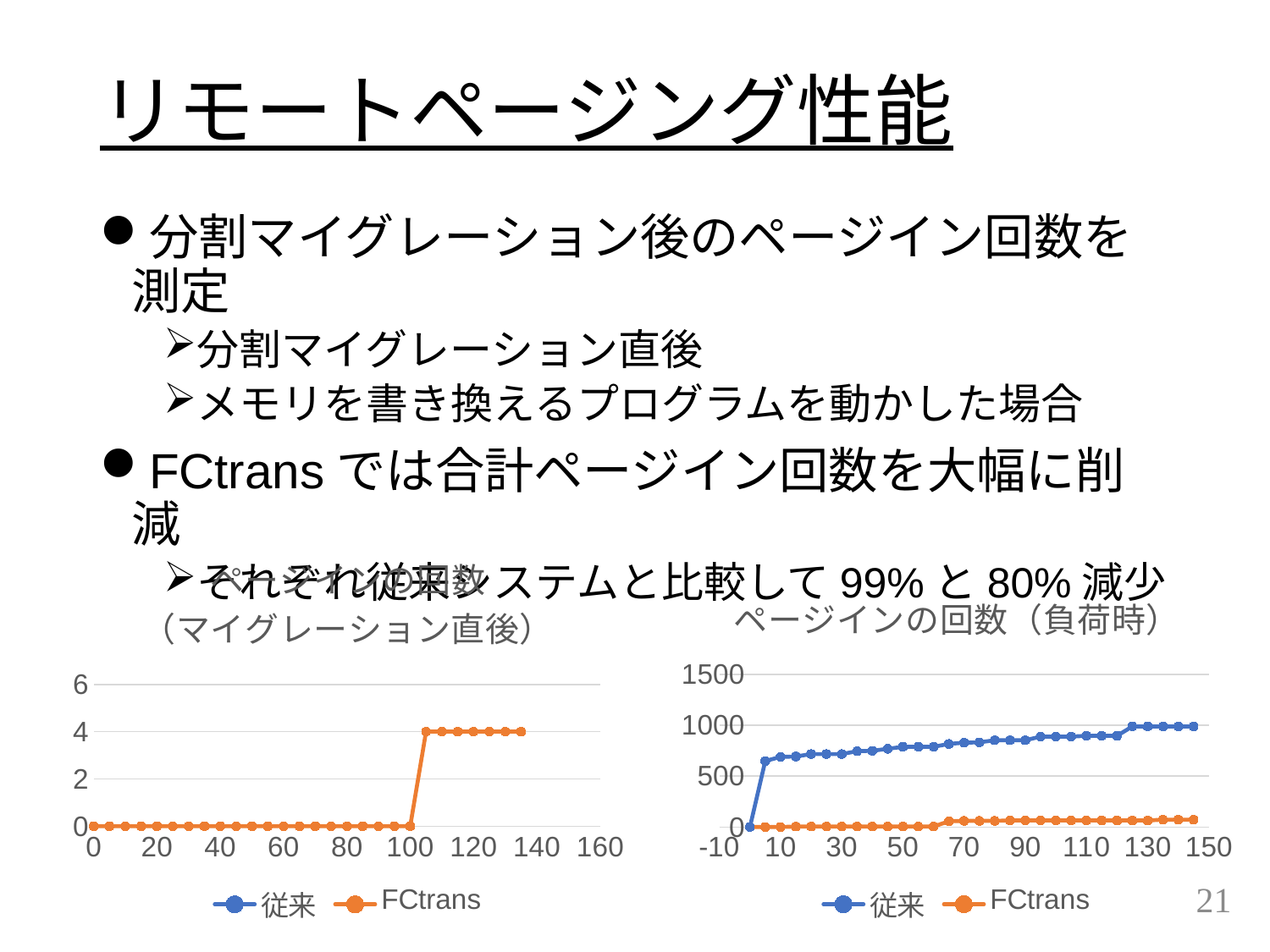
In the left chart, what is the value of the FCtrans line at x = 0? 0 In the right chart titled ページインの回数（負荷時）, is the value for 従来 at x = 140 greater or less than 1500? less In the right chart titled ページインの回数（負荷時）, which series has the higher value at x = 100, 従来 or FCtrans? 従来 In the right chart titled ページインの回数（負荷時）, does the 従来 line rise or fall as x increases? rise In the left chart, is the value for FCtrans at x = 120 greater or less than 2? greater In the left chart, what value does the FCtrans line reach after x = 100? 4 In the right chart titled ページインの回数（負荷時）, is the value for FCtrans at x = 130 greater or less than 500? less What are the two series named in the legend of the right chart titled ページインの回数（負荷時）? 従来 and FCtrans What colour is the FCtrans line in the right chart titled ページインの回数（負荷時）? orange How many series does the legend of the left chart list? 2 What kind of chart is the right chart titled ページインの回数（負荷時）? line chart